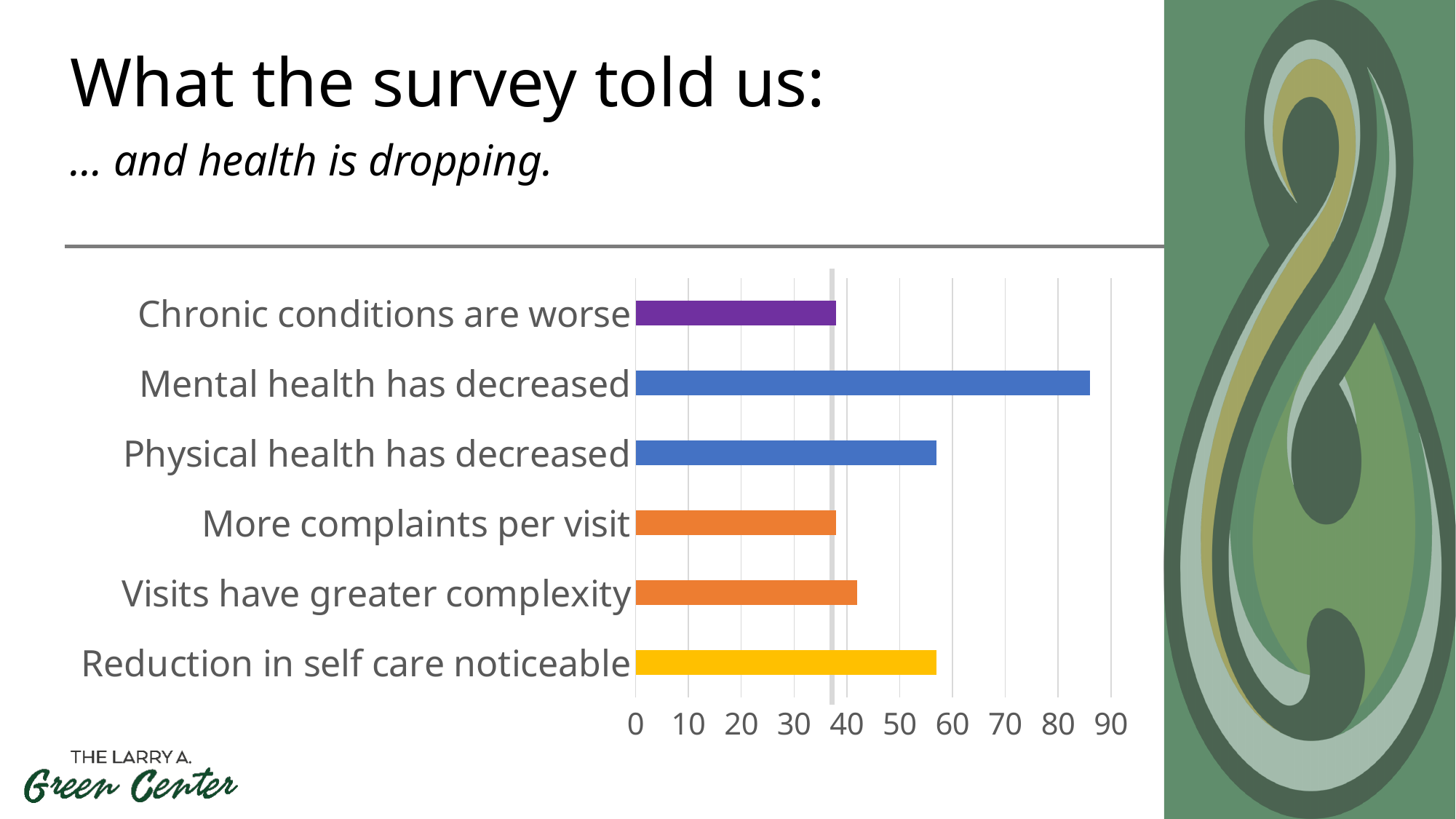
Which is larger, the value for "Reduction in self care noticeable" or the value for "Chronic conditions are worse"? Reduction in self care noticeable Is the value for "Visits have greater complexity" greater or less than 50? less Is the value for "Chronic conditions are worse" greater or less than 30? greater Is the value for "Mental health has decreased" greater or less than 80? greater Which is larger, the value for "Mental health has decreased" or the value for "Physical health has decreased"? Mental health has decreased Which category has the highest value in the bar chart? Mental health has decreased What colour is the bar for "Mental health has decreased"? blue How many categories are plotted in the bar chart? 6 What kind of chart is shown on the slide? bar chart